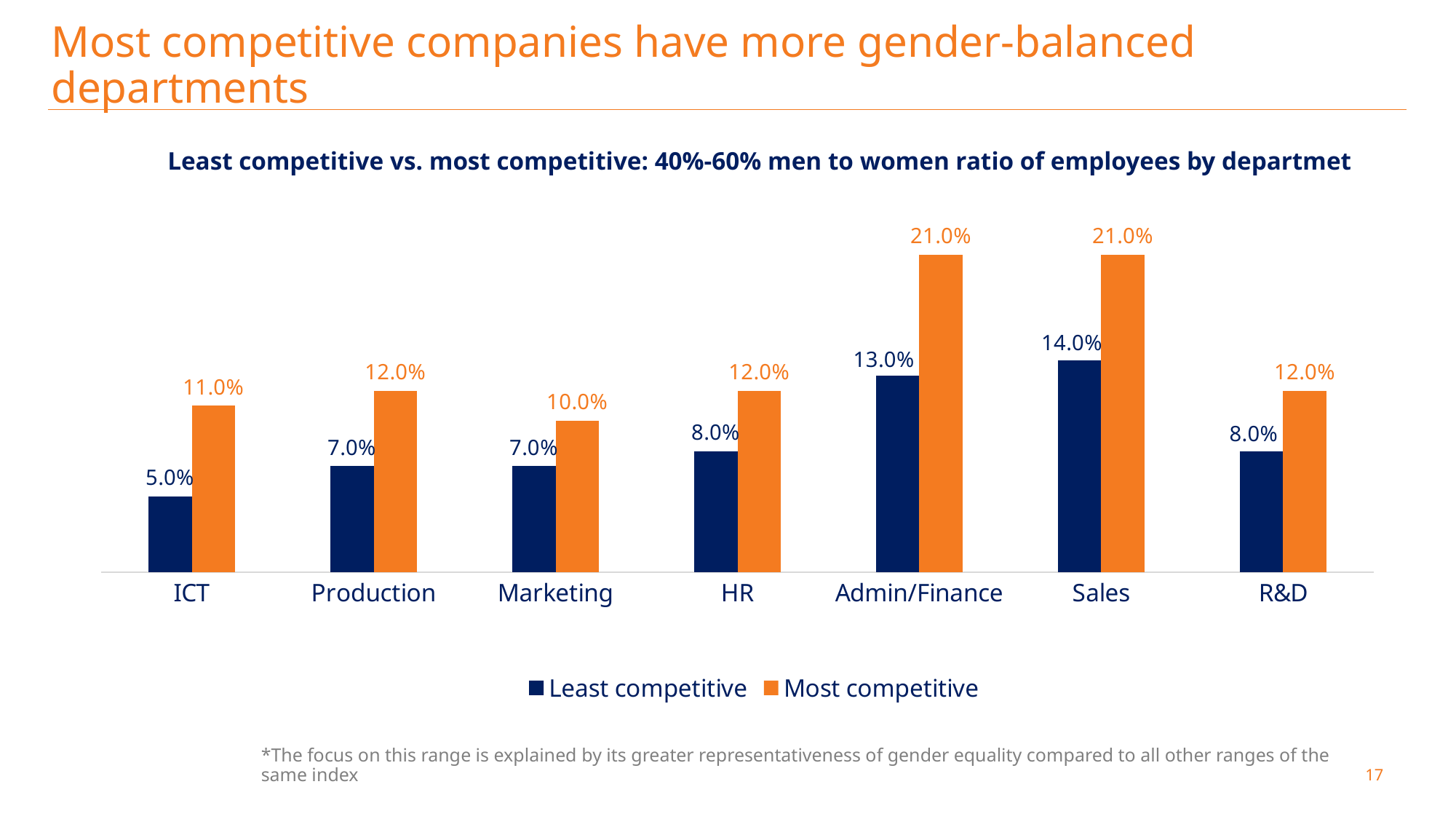
Which is larger in the HR department: Least competitive or Most competitive? Most competitive Which colour represents the Most competitive series? Orange Which department has the highest value for Least competitive? Sales What is the value for Most competitive in the Marketing department? 10.0% What is the difference between Most competitive and Least competitive in the ICT department? 6.0% Which department has the lowest value for Least competitive? ICT How many departments are shown on the x axis? 7 What is the value for Most competitive in the Admin/Finance department? 21.0% How many series does the legend list? 2 What is the difference between Most competitive and Least competitive in the Sales department? 7.0% What is the value for Least competitive in the ICT department? 5.0% What kind of chart is shown on the slide? Bar chart